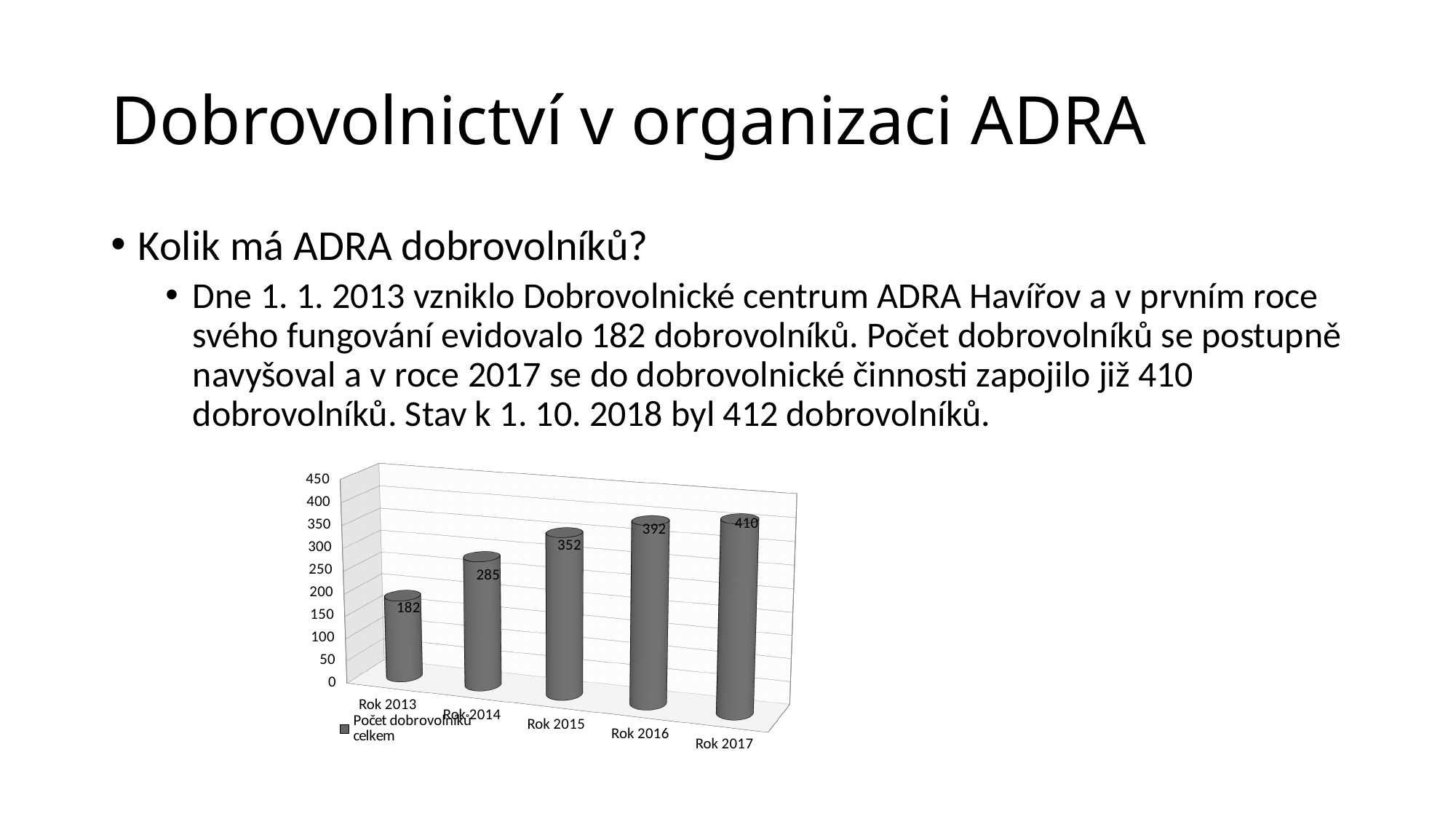
Do the values rise or fall from Rok 2013 to Rok 2017? rise Which is larger, the value for Rok 2014 or the value for Rok 2016? Rok 2016 What is the value for Rok 2015? 352 What is the difference between the values for Rok 2017 and Rok 2013? 228 Which year has the lowest value? Rok 2013 What is the value for Rok 2017? 410 How many years are shown on the x axis? 5 What is the value for Rok 2013? 182 Which year has the highest value? Rok 2017 What kind of chart is this? bar chart What is the difference between the values for Rok 2016 and Rok 2015? 40 What series name does the legend show? Počet dobrovolníků celkem